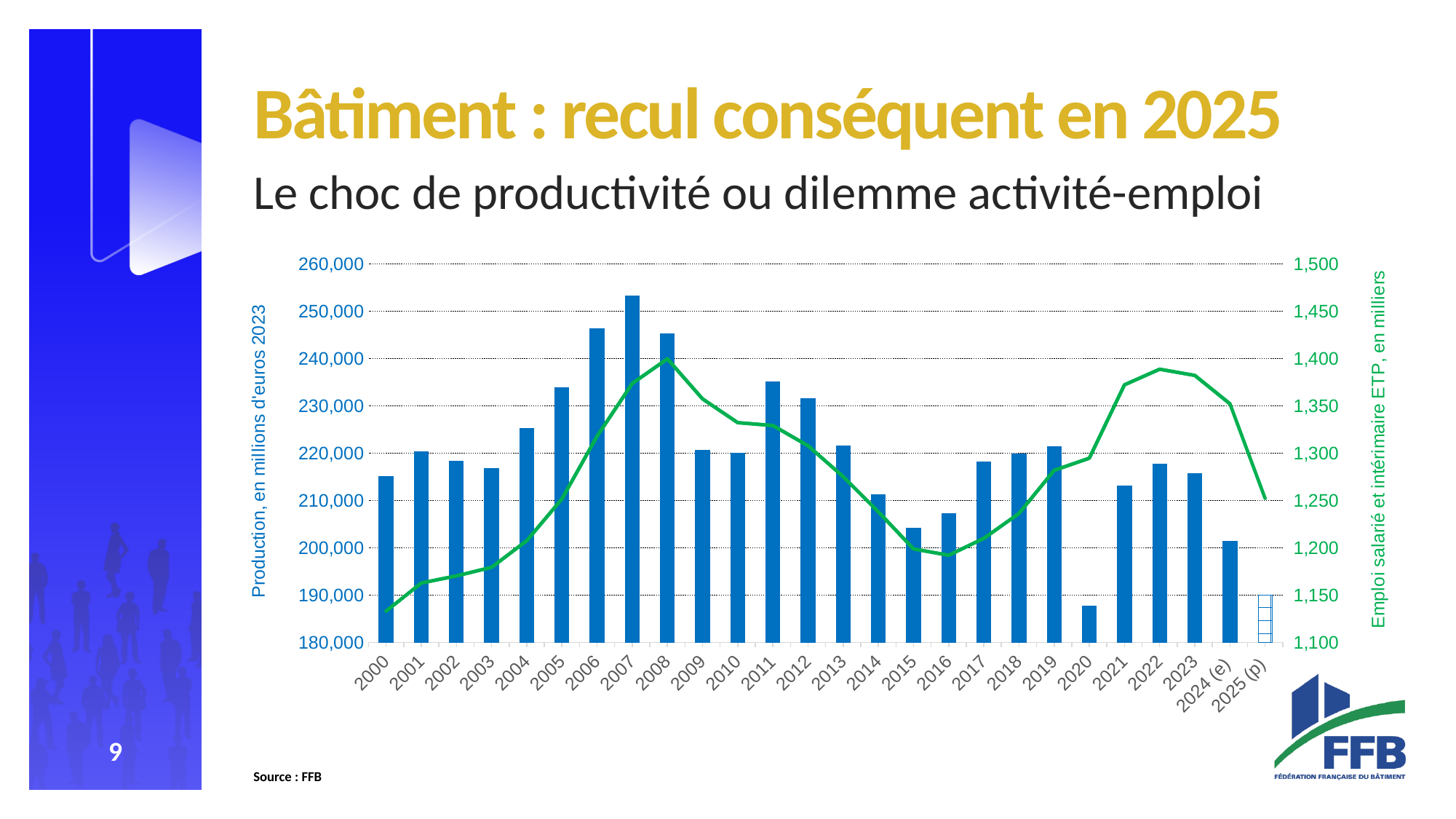
In which year is the production bar the highest? 2007 Is the employment (green line) value for 2022 greater or less than 1,350? greater What kind of chart is shown on the slide? A combined bar and line chart What is the title of the left vertical axis? Production, en millions d'euros 2023 How many years (categories) are shown along the x axis? 26 Is the employment (green line) value for 2025 (p) greater or less than 1,300? less Is the production value for 2020 greater or less than 190,000? less Do the production bars rise or fall from 2000 to 2007? Rise Which year has the higher production bar, 2007 or 2008? 2007 In which year is the production bar the lowest? 2020